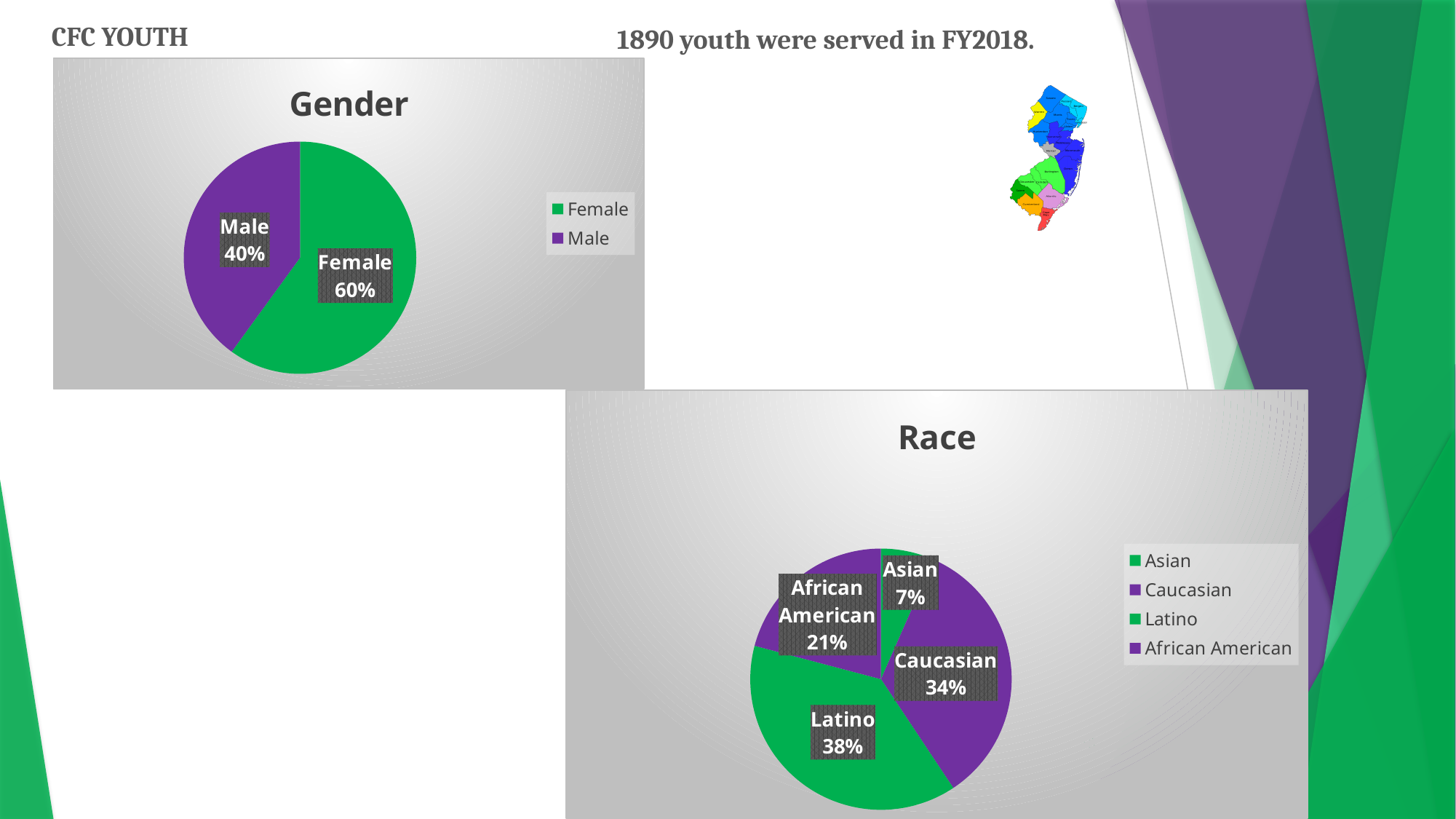
In the Race chart, what percentage of youth are Caucasian? 34% What kind of chart is the Gender chart? Pie chart In the Race chart, what is the difference in percentage points between Caucasian and Asian? 27 In the Race chart, what percentage of youth are African American? 21% In the Gender chart, which category has the larger share? Female In the Gender chart, what is the difference in percentage points between Female and Male? 20 In the Gender chart, what percentage of youth are Female? 60% In the Race chart, which category has the largest share? Latino In the Gender chart, what percentage of youth are Male? 40% In the Race chart, how many categories does the legend list? 4 In the Race chart, which category has the smallest share? Asian In the Race chart, what percentage of youth are Latino? 38%